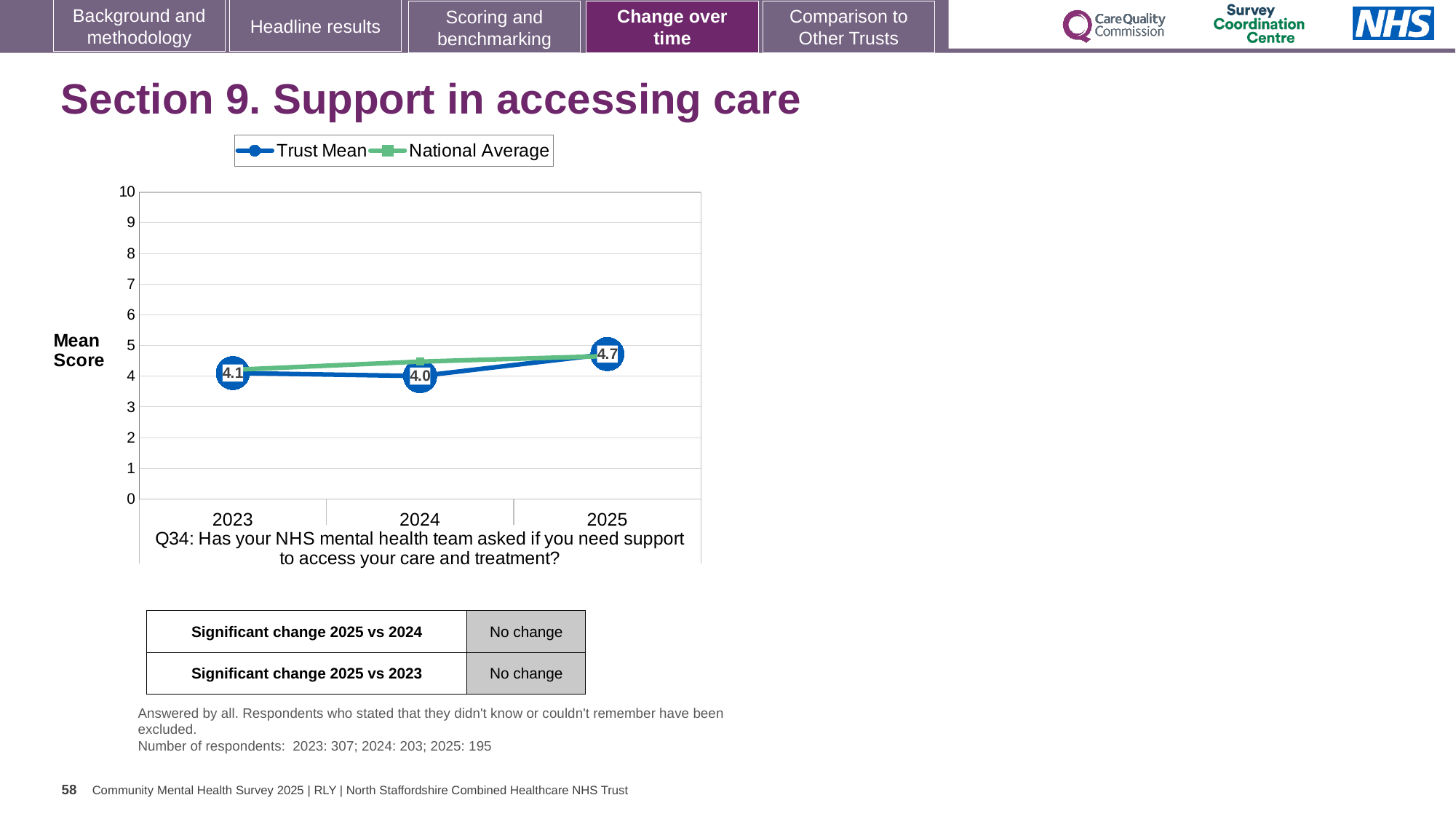
What is the Trust Mean score for 2025? 4.7 In which year is the Trust Mean score lowest? 2024 In which year is the Trust Mean score highest? 2025 How many series does the legend list? 2 What is the label on the y axis of the chart? Mean Score What kind of chart is shown on the slide? line chart Is the National Average value for 2025 greater or less than 5? less What is the Trust Mean score for 2023? 4.1 What is the difference between the Trust Mean scores for 2025 and 2024? 0.7 How many years are plotted on the x axis? 3 Is the Trust Mean score higher in 2023 or in 2025? 2025 What is the Trust Mean score for 2024? 4.0